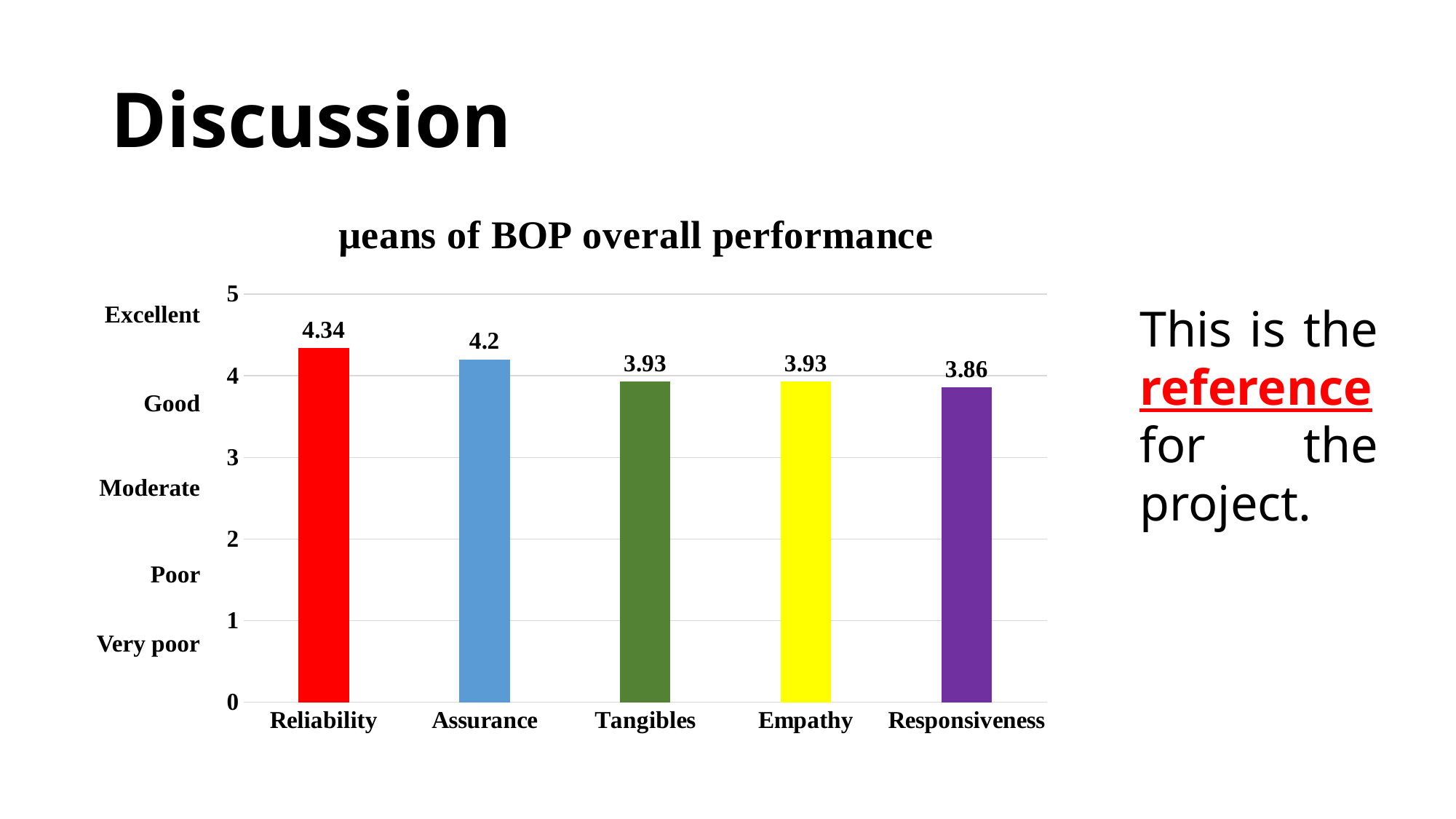
How many categories are shown on the x axis? 5 Which is larger, the value for Assurance or the value for Empathy? Assurance What is the title of the chart? μeans of BOP overall performance Which category has the highest value? Reliability What is the difference between the values for Reliability and Responsiveness? 0.48 Which category has the lowest value? Responsiveness What is the value for Reliability? 4.34 What is the value for Assurance? 4.2 What is the value for Responsiveness? 3.86 What is the difference between the values for Assurance and Tangibles? 0.27 What kind of chart is shown on the slide? Bar chart What is the value for Empathy? 3.93